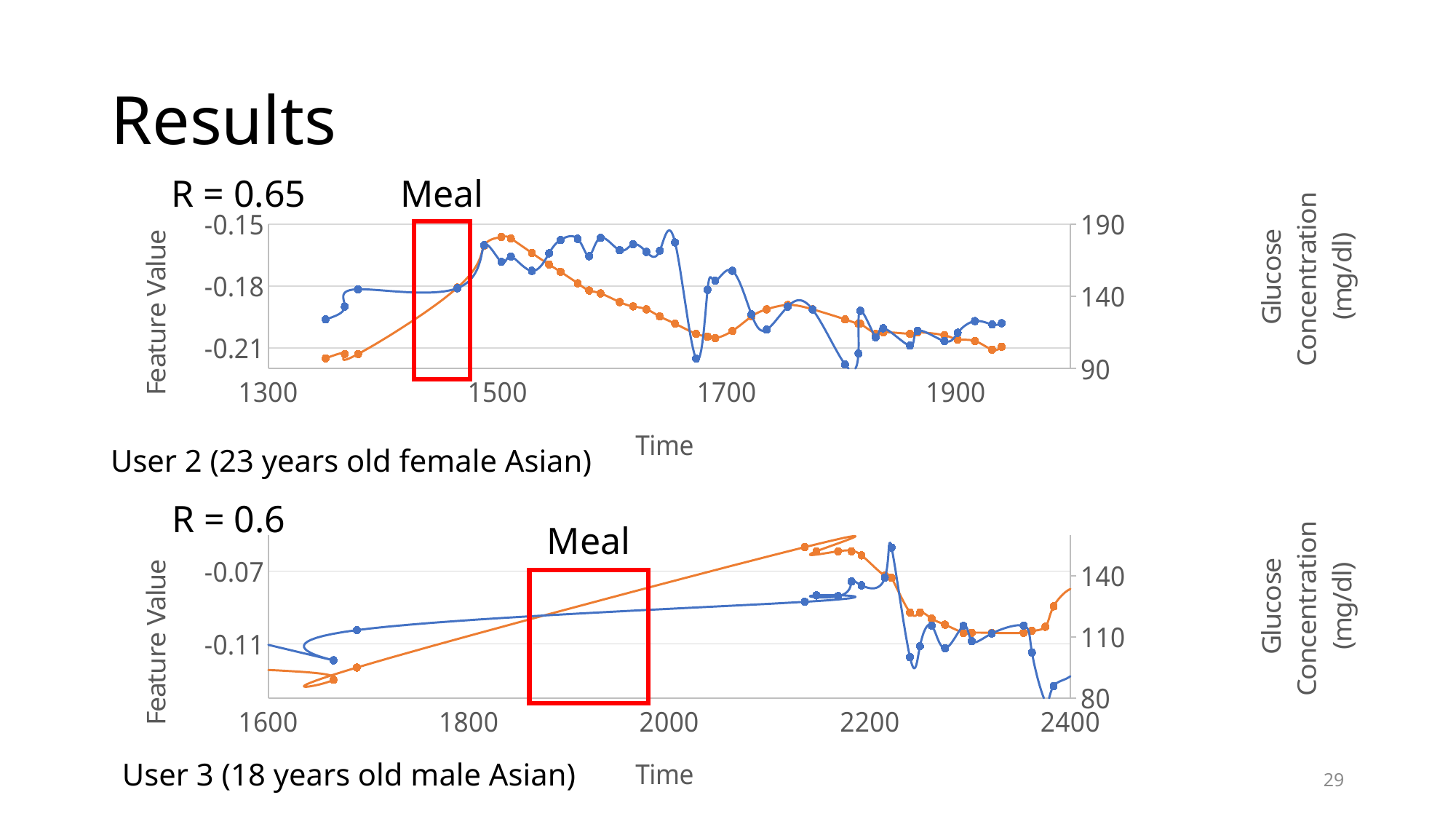
In the top chart (User 2), is the orange glucose line at time 1500 greater or less than 140 mg/dl? greater In the bottom chart (User 3), is the orange glucose line at time 1650 greater or less than 110 mg/dl? less In the top chart (User 2), is the blue feature value line at time 1800 greater or less than -0.18? less In the bottom chart (User 3), does the orange glucose line rise or fall between time 1600 and time 2200? rise What is the R value shown above the bottom chart (User 3)? R = 0.6 What is the R value shown above the top chart (User 2)? R = 0.65 In the top chart (User 2), does the orange glucose line rise or fall between time 1500 and time 1700? fall What kind of chart is the bottom chart (User 3)? line chart What kind of chart is the top chart (User 2)? line chart